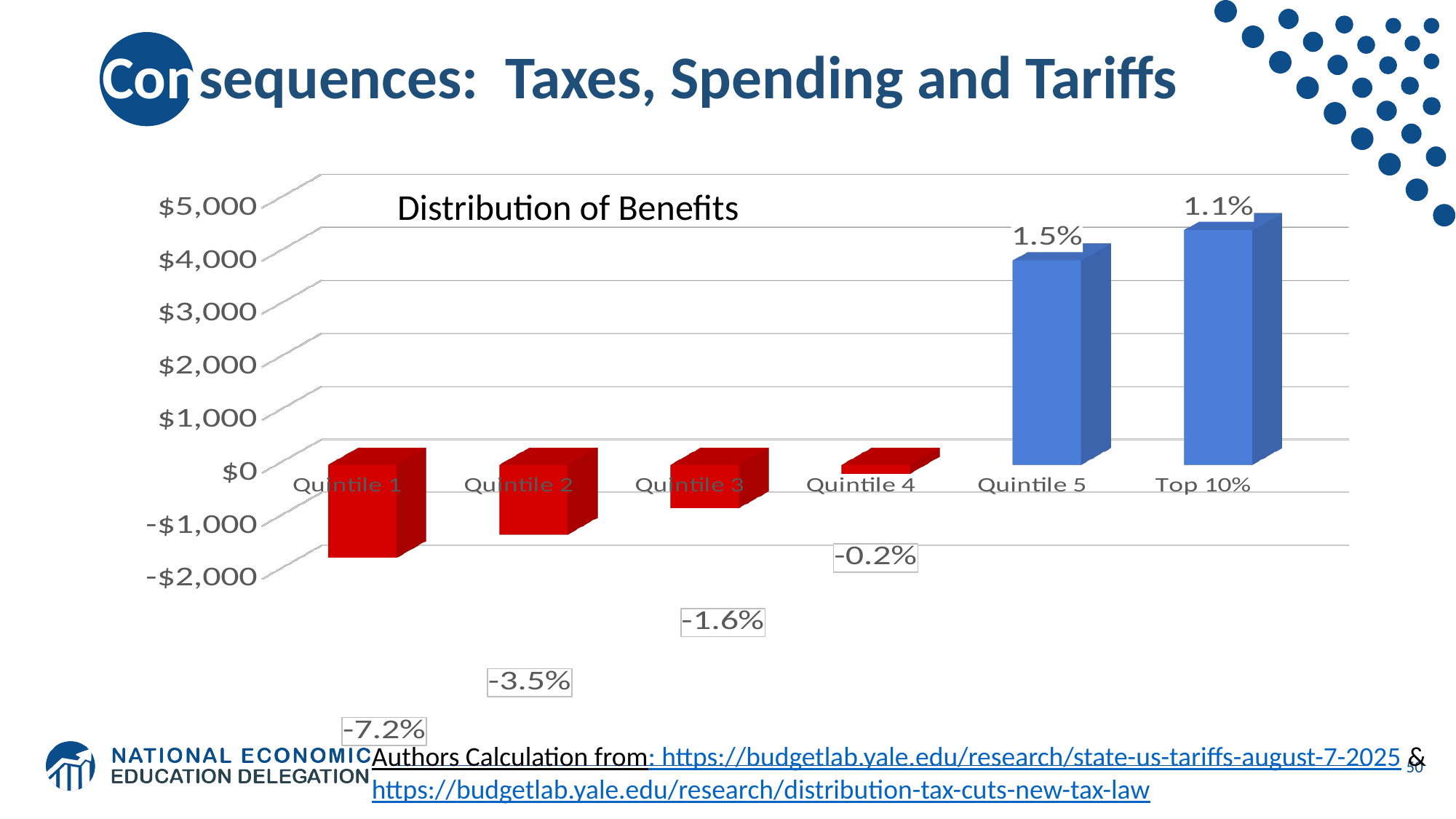
Which bar extends further below zero, Quintile 1 or Quintile 2? Quintile 1 What is the difference between the labelled values for Quintile 5 and Top 10%? 0.4% Which category has the lowest labelled value? Quintile 1 What is the title of the chart? Distribution of Benefits How many categories are shown on the x axis of the chart? 6 What is the data label shown for Quintile 1? -7.2% What is the data label shown for Quintile 5? 1.5% What is the data label shown for Quintile 4? -0.2% What is the data label shown for Top 10%? 1.1% Which category has the highest labelled value? Quintile 5 What kind of chart is shown on the slide? bar chart Is the bar for Quintile 5 greater or less than $3,000? greater